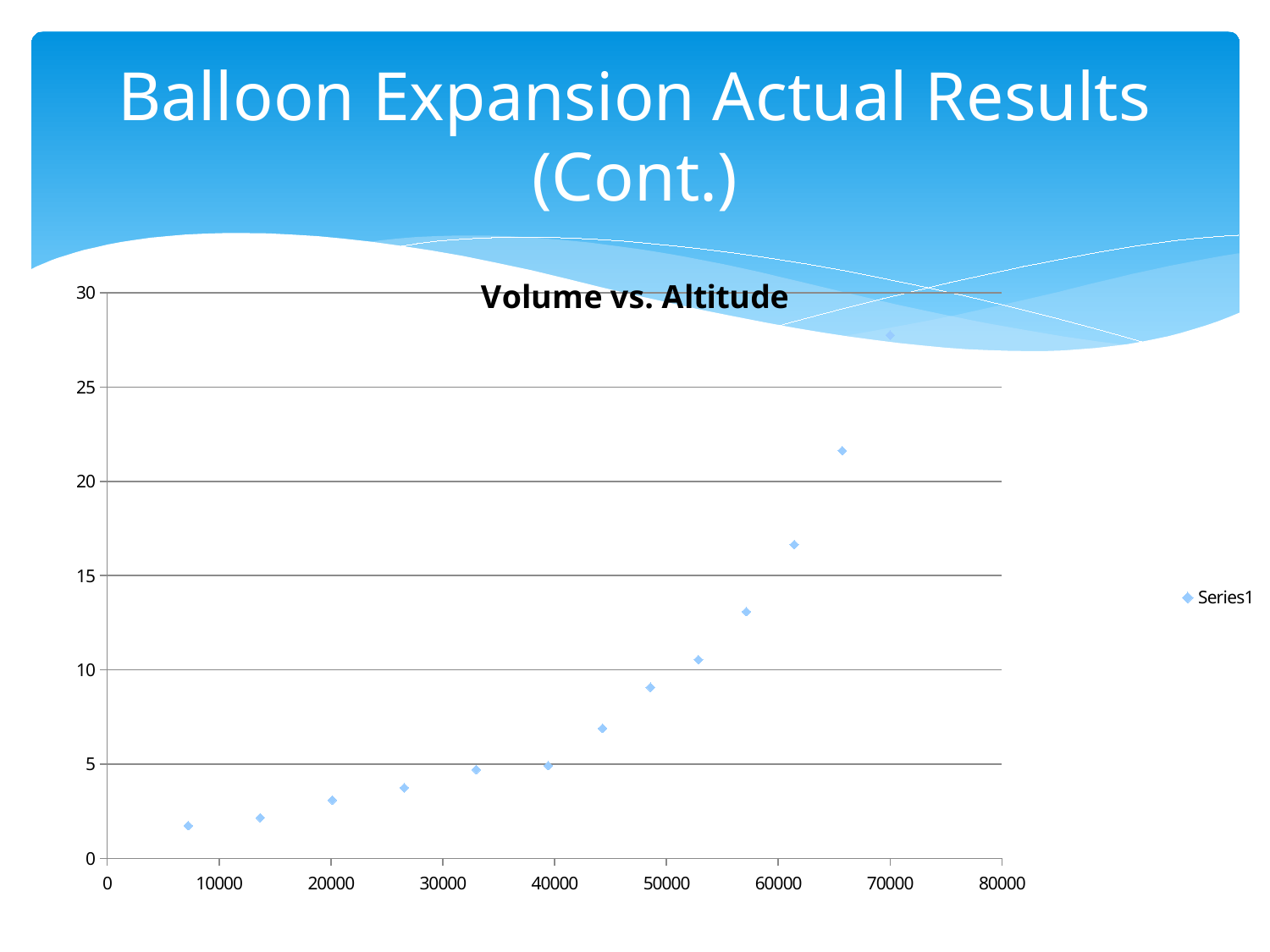
Is the value of the rightmost point (near x = 70000) greater or less than 25? greater What is the name of the series shown in the legend? Series1 How many data points are plotted on the chart? 13 Do the plotted values rise or fall as the x-axis value increases? rise Is the value of the leftmost point (near x = 7000) greater or less than 5? less What is the maximum value shown on the y axis? 30 Which has the larger value: the point near x = 20000 or the point near x = 50000? the point near x = 50000 What is the title of the chart? Volume vs. Altitude Is the value of the point near x = 57000 greater or less than 15? less How many series does the legend list? 1 What kind of chart is shown on the slide? scatter chart